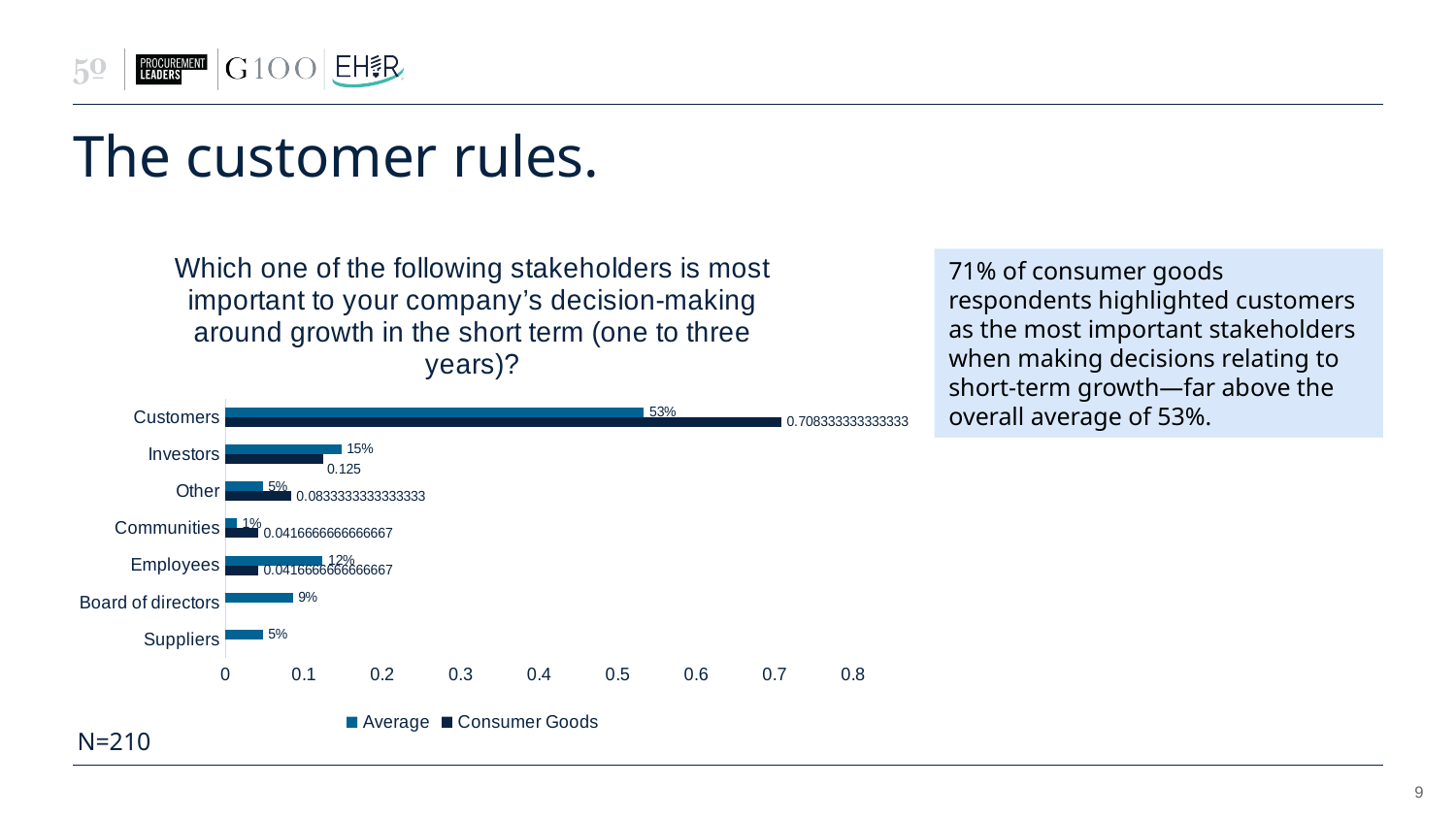
What kind of chart is shown on the slide? Bar chart What are the two series named in the chart legend? Average and Consumer Goods Which has the larger Average value, Investors or Employees? Investors Which stakeholder has the highest Average value? Customers What is the Consumer Goods value for Investors? 0.125 What is the Average value for Board of directors? 9% What is the Average value for Employees? 12% How many stakeholder categories are plotted on the chart? 7 Which stakeholder has the lowest Average value? Communities What is the Consumer Goods value for Customers? 0.708333333333333 How many series does the chart's legend list? 2 What is the Average value for Customers? 53%